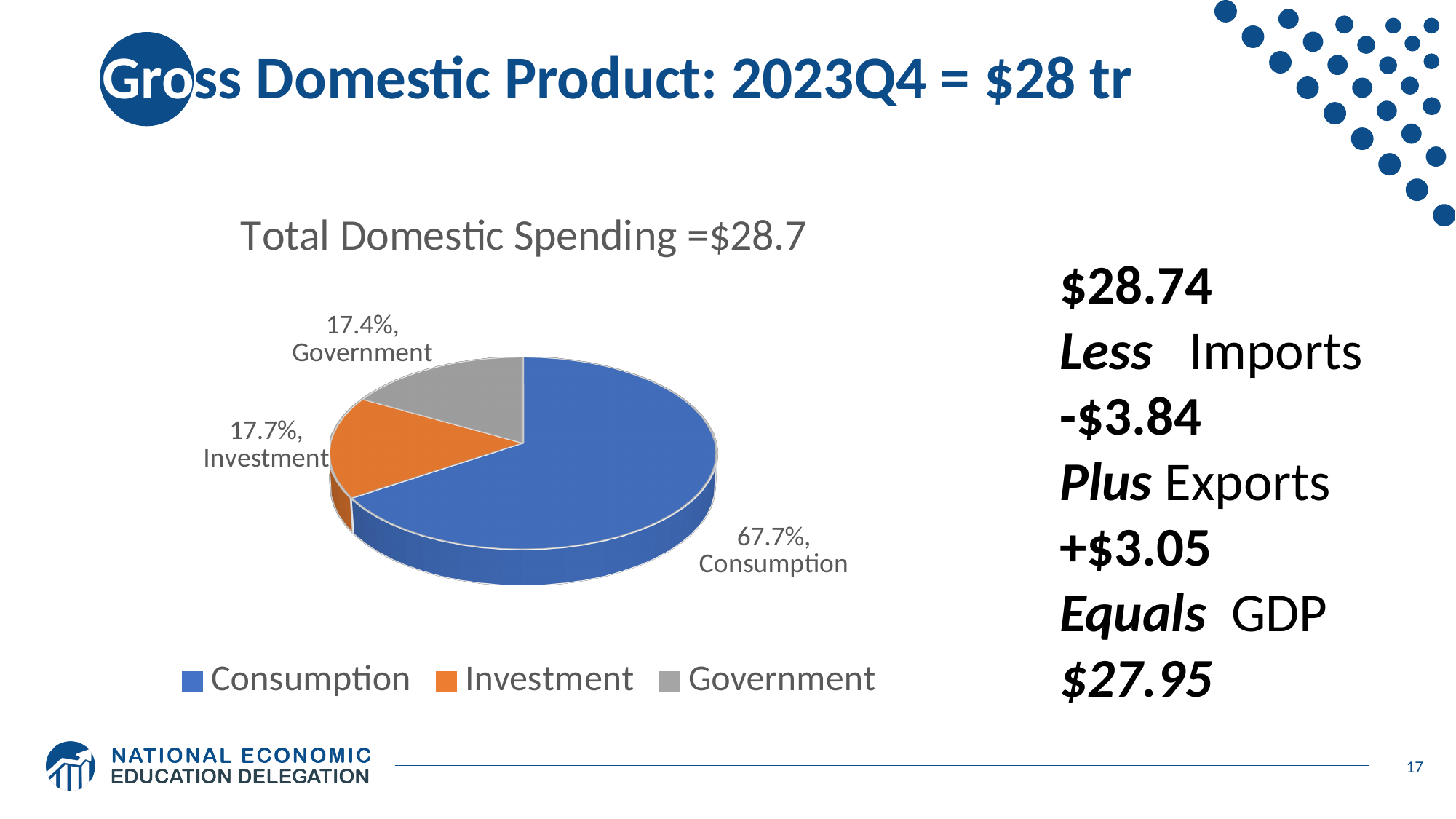
Which category has the largest slice of the pie? Consumption What share of the pie does Consumption represent? 67.7% What kind of chart is shown on the slide? Pie chart What is the title of the chart? Total Domestic Spending =$28.7 Which colour represents Investment in the pie chart? Orange How many categories are shown in the pie chart? 3 What share of the pie does Investment represent? 17.7% What is the difference in percentage points between the Consumption and Investment slices? 50 percentage points What is the difference in percentage points between the Investment and Government slices? 0.3 percentage points Which category has the smallest slice of the pie? Government What share of the pie does Government represent? 17.4% How many entries does the legend list? 3